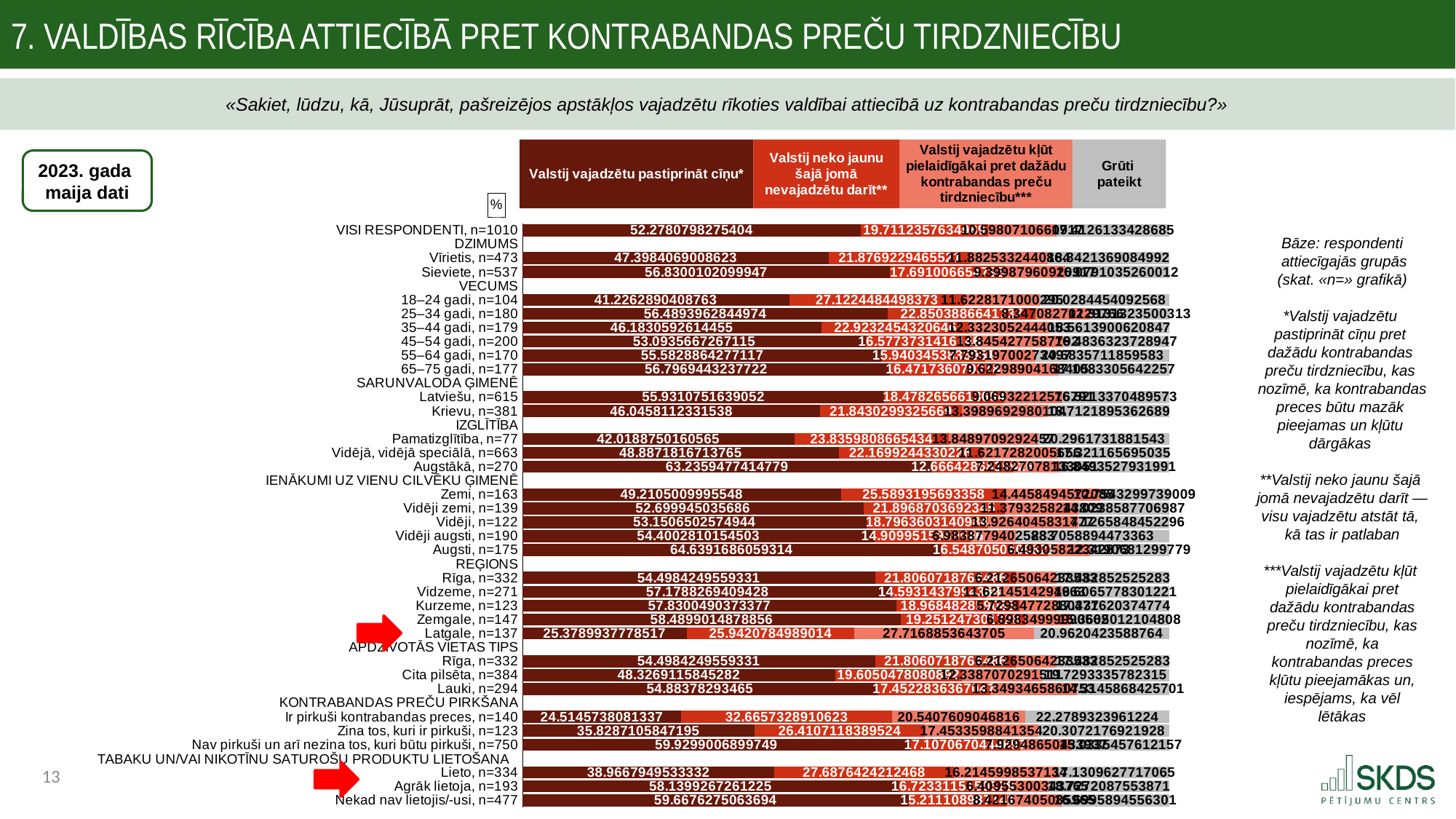
Which group has the highest value for "Valstij vajadzētu pastiprināt cīņu*"? Augsti, n=175 What is the value of "Valstij vajadzētu pastiprināt cīņu*" for Sieviete, n=537? 56.8300102099947 What is the value of "Valstij vajadzētu pastiprināt cīņu*" for VISI RESPONDENTI, n=1010? 52.2780798275404 What kind of chart is shown on the slide? Stacked bar chart What is the value of "Valstij vajadzētu pastiprināt cīņu*" for Lieto, n=334? 38.9667949533332 What is the value of "Valstij neko jaunu šajā jomā nevajadzētu darīt**" for Ir pirkuši kontrabandas preces, n=140? 32.6657328910623 Which has a larger "Valstij vajadzētu pastiprināt cīņu*" value: Augstākā, n=270 or Pamatizglītība, n=77? Augstākā, n=270 How many response categories (series) does the legend at the top of the chart list? 4 What is the difference between the "Valstij vajadzētu pastiprināt cīņu*" values for Sieviete, n=537 and Vīrietis, n=473? 9.4316033091324 Which group has the lowest value for "Valstij vajadzētu pastiprināt cīņu*"? Ir pirkuši kontrabandas preces, n=140 What is the value of "Grūti pateikt" for Latgale, n=137? 20.9620423588764 What colour is used for the "Grūti pateikt" series in the chart? Grey